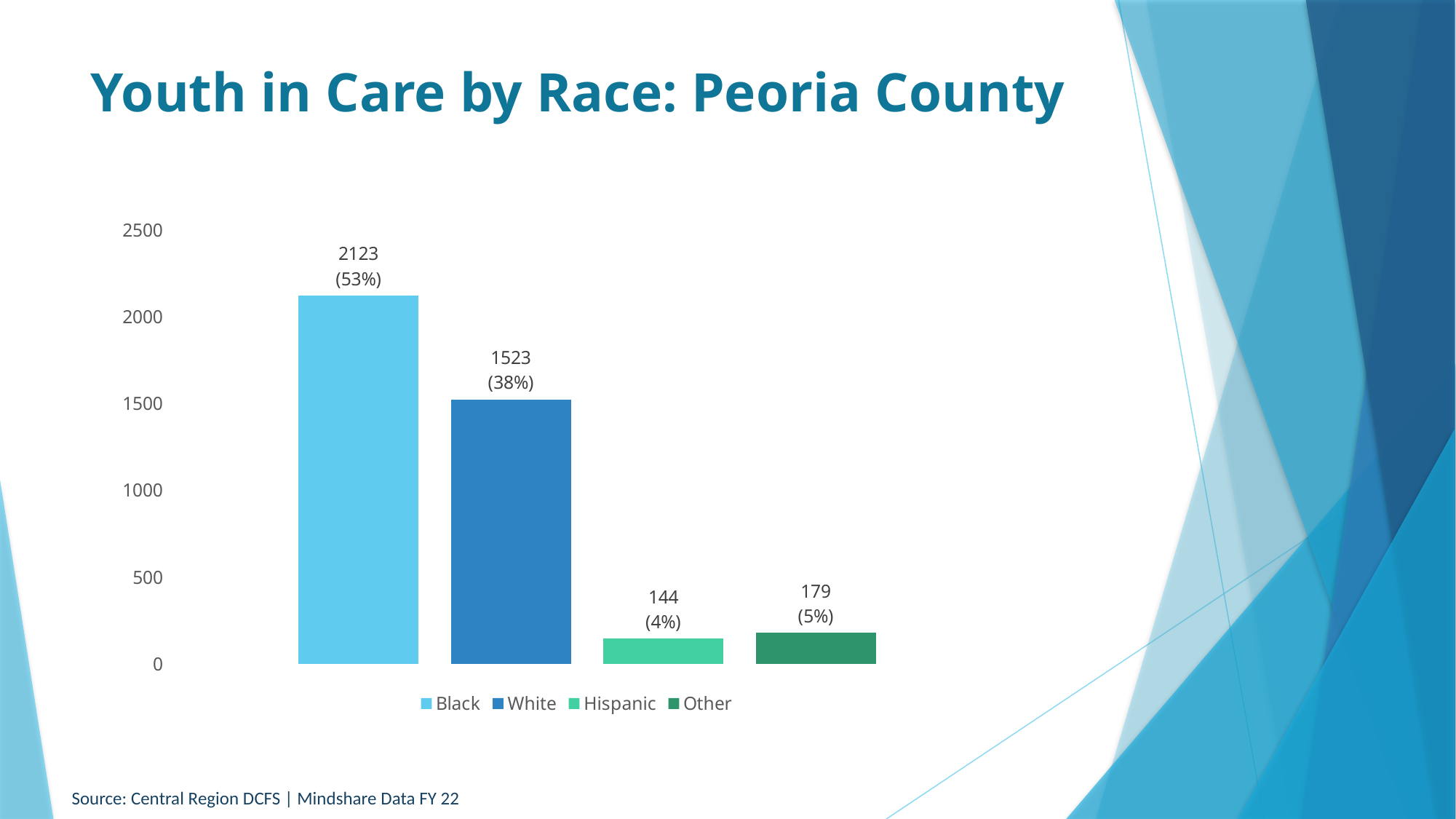
How many race categories are shown in the chart? 4 Which has more youth in care, Hispanic or Other? Other Which race category has the highest number of youth in care? Black What is the number of youth in care for Hispanic youth in Peoria County? 144 What is the number of youth in care for White youth in Peoria County? 1523 What is the difference between the number of Black and White youth in care? 600 What percentage of youth in care in Peoria County are labelled Other? 5% What is the number of youth in care for Black youth in Peoria County? 2123 Is the value for White youth in care greater or less than 2000? less Which race category has the lowest number of youth in care? Hispanic What is the title of the chart on the slide? Youth in Care by Race: Peoria County What kind of chart is shown on the slide? Bar chart